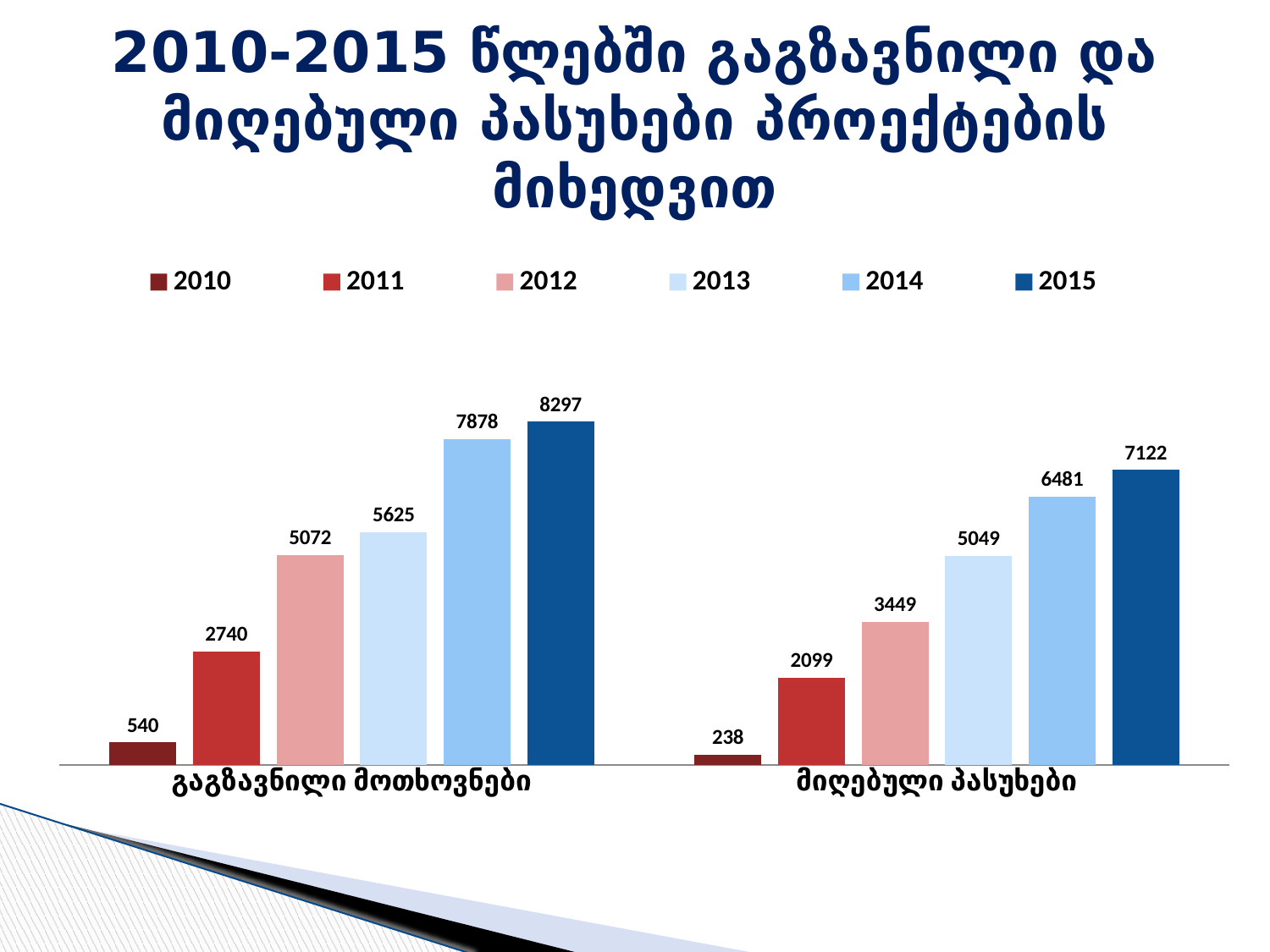
What is the value for 2013 in the "მიღებული პასუხები" category? 5049 What kind of chart is shown on the slide? Bar chart What is the difference between the 2015 values of "გაგზავნილი მოთხოვნები" and "მიღებული პასუხები"? 1175 What is the difference between the 2015 and 2014 values in the "გაგზავნილი მოთხოვნები" category? 419 What is the value for 2015 in the "გაგზავნილი მოთხოვნები" category? 8297 How many categories are shown on the x axis? 2 Which year has the highest value in the "გაგზავნილი მოთხოვნები" category? 2015 How many series does the legend list? 6 Which is larger: the 2012 value for "გაგზავნილი მოთხოვნები" or the 2012 value for "მიღებული პასუხები"? გაგზავნილი მოთხოვნები Do the values in the "მიღებული პასუხები" category rise or fall from 2010 to 2015? Rise Which year has the lowest value in the "მიღებული პასუხები" category? 2010 What is the value for 2010 in the "მიღებული პასუხები" category? 238